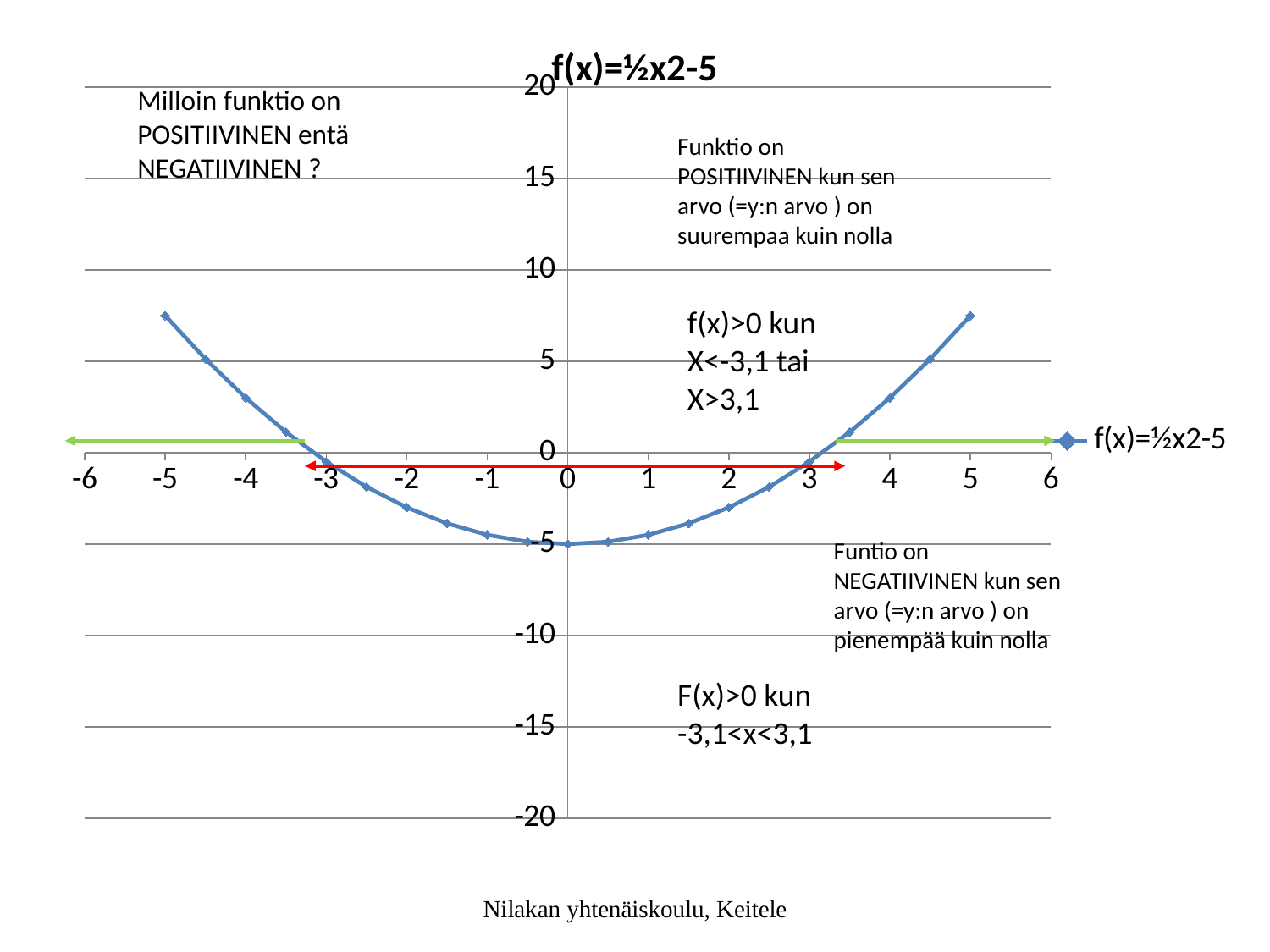
How many series does the chart legend list? 1 What kind of chart is shown on the slide? line chart Do the plotted values rise or fall as x increases from -5 to 0? fall What is the title of the chart? f(x)=½x2-5 Which is larger, the value of f(x) at x = 5 or at x = 4? x = 5 Is the value of f(x) at x = 5 greater or less than 5? greater Do the plotted values rise or fall as x increases from 0 to 5? rise What is the value of f(x) at x = 0? -5 Is the value of f(x) at x = -5 greater or less than 5? greater Is the value of f(x) at x = 2 greater or less than 0? less At which x value does the plotted curve reach its lowest point? 0